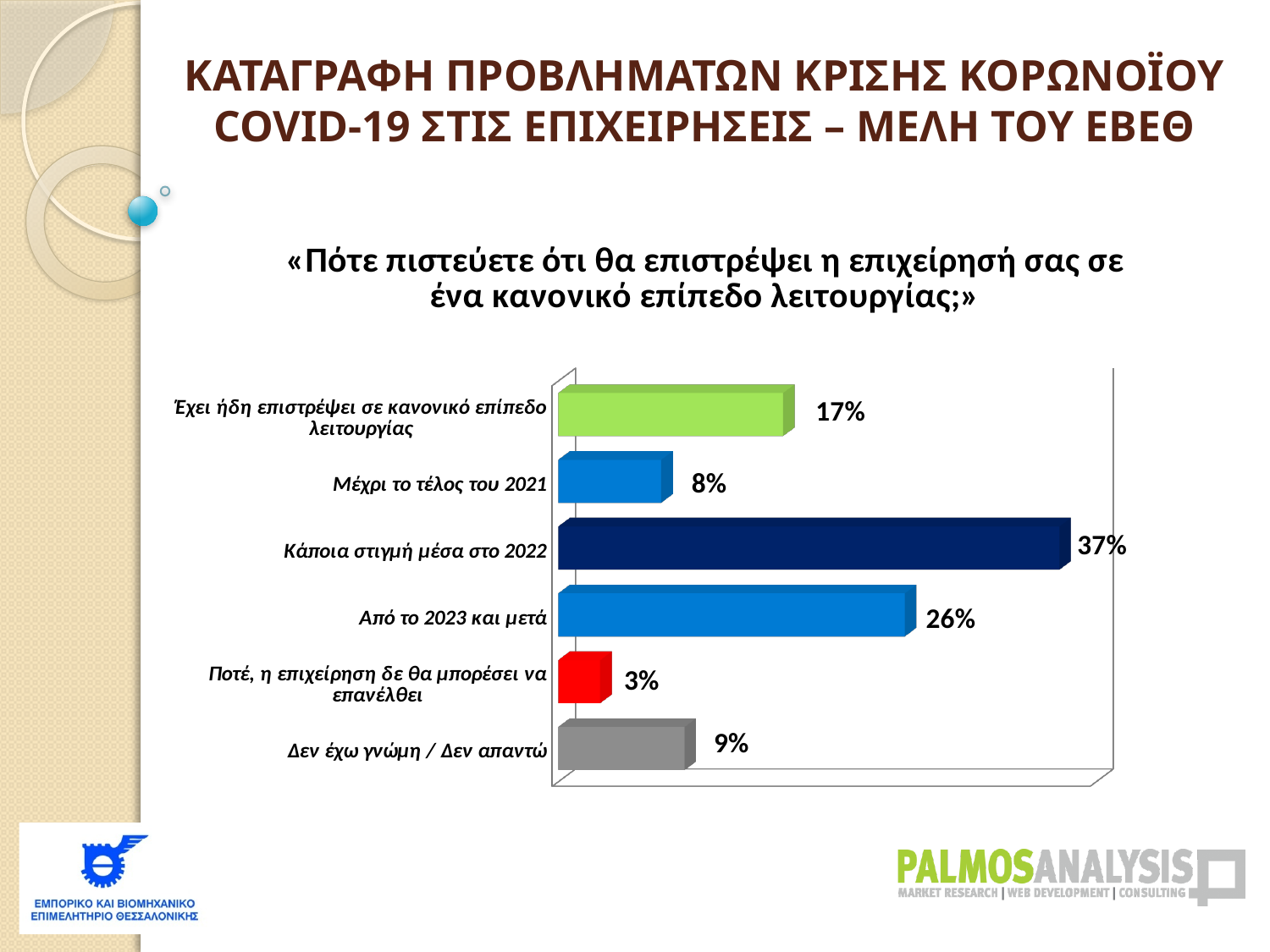
Which category has the highest value? Κάποια στιγμή μέσα στο 2022 What is the difference between the values for "Κάποια στιγμή μέσα στο 2022" and "Από το 2023 και μετά"? 11% Which is larger: the value for "Μέχρι το τέλος του 2021" or the value for "Δεν έχω γνώμη / Δεν απαντώ"? Δεν έχω γνώμη / Δεν απαντώ What is the value for "Δεν έχω γνώμη / Δεν απαντώ"? 9% What is the value for "Έχει ήδη επιστρέψει σε κανονικό επίπεδο λειτουργίας"? 17% What percentage of respondents answered "Κάποια στιγμή μέσα στο 2022"? 37% How many categories are shown in the chart? 6 What is the difference between the values for "Έχει ήδη επιστρέψει σε κανονικό επίπεδο λειτουργίας" and "Μέχρι το τέλος του 2021"? 9% Which category has the lowest value? Ποτέ, η επιχείρηση δε θα μπορέσει να επανέλθει What kind of chart is shown on the slide? Bar chart What is the value for "Από το 2023 και μετά"? 26% What colour is the bar for "Ποτέ, η επιχείρηση δε θα μπορέσει να επανέλθει"? Red